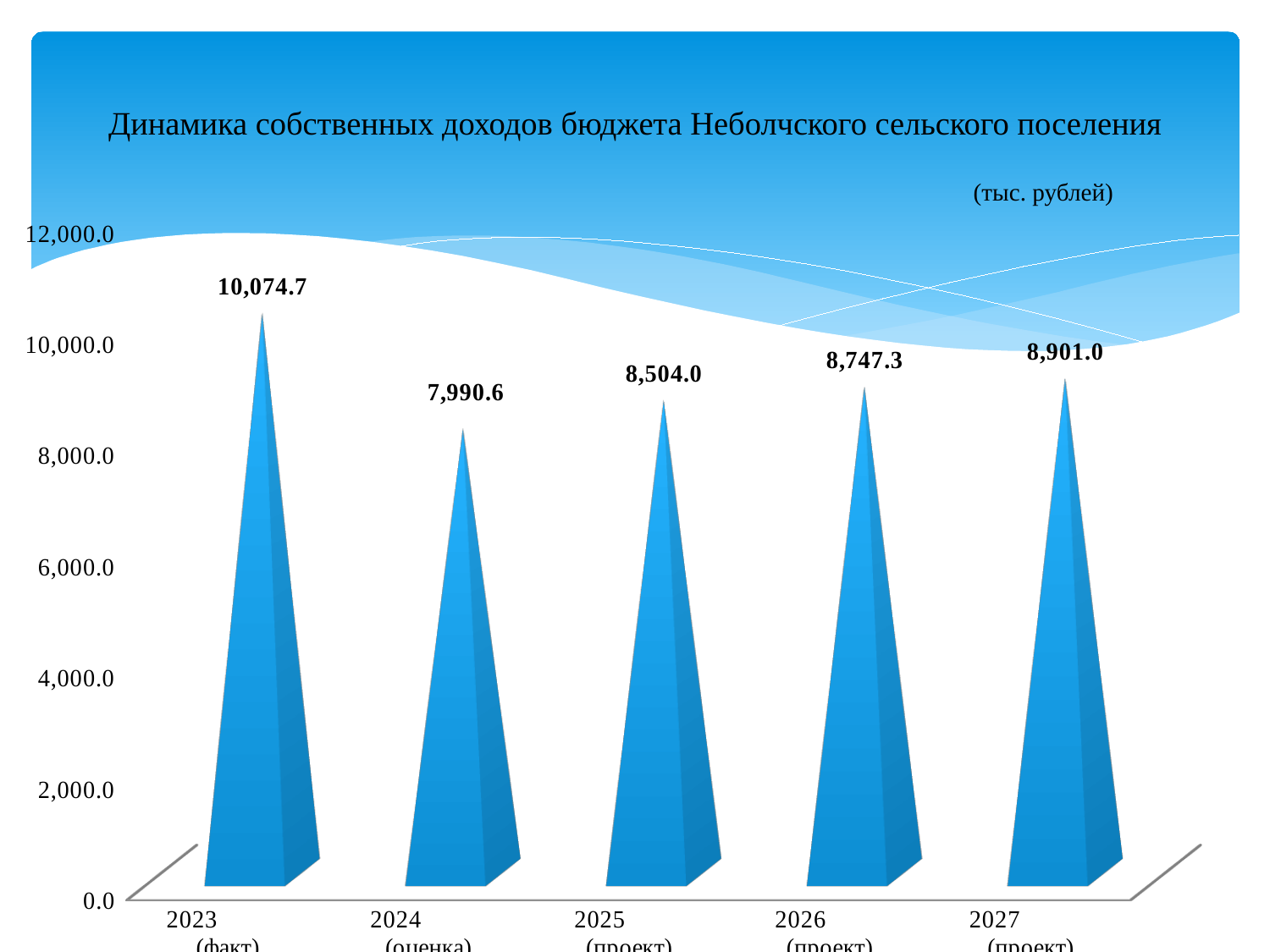
Do the values rise or fall from 2024 to 2027? rise What is the value for 2024 (оценка)? 7,990.6 What kind of chart is shown on the slide? bar chart What is the difference between the values for 2027 and 2025? 397.0 Is the value for 2023 greater or less than 10,000.0? greater Which year has the lowest value? 2024 (оценка) What is the difference between the values for 2023 and 2024? 2,084.1 How many years are shown on the chart? 5 What is the value for 2027 (проект)? 8,901.0 What is the value for 2023 (факт)? 10,074.7 Which is larger, the value for 2025 or the value for 2026? 2026 Which year has the highest value? 2023 (факт)